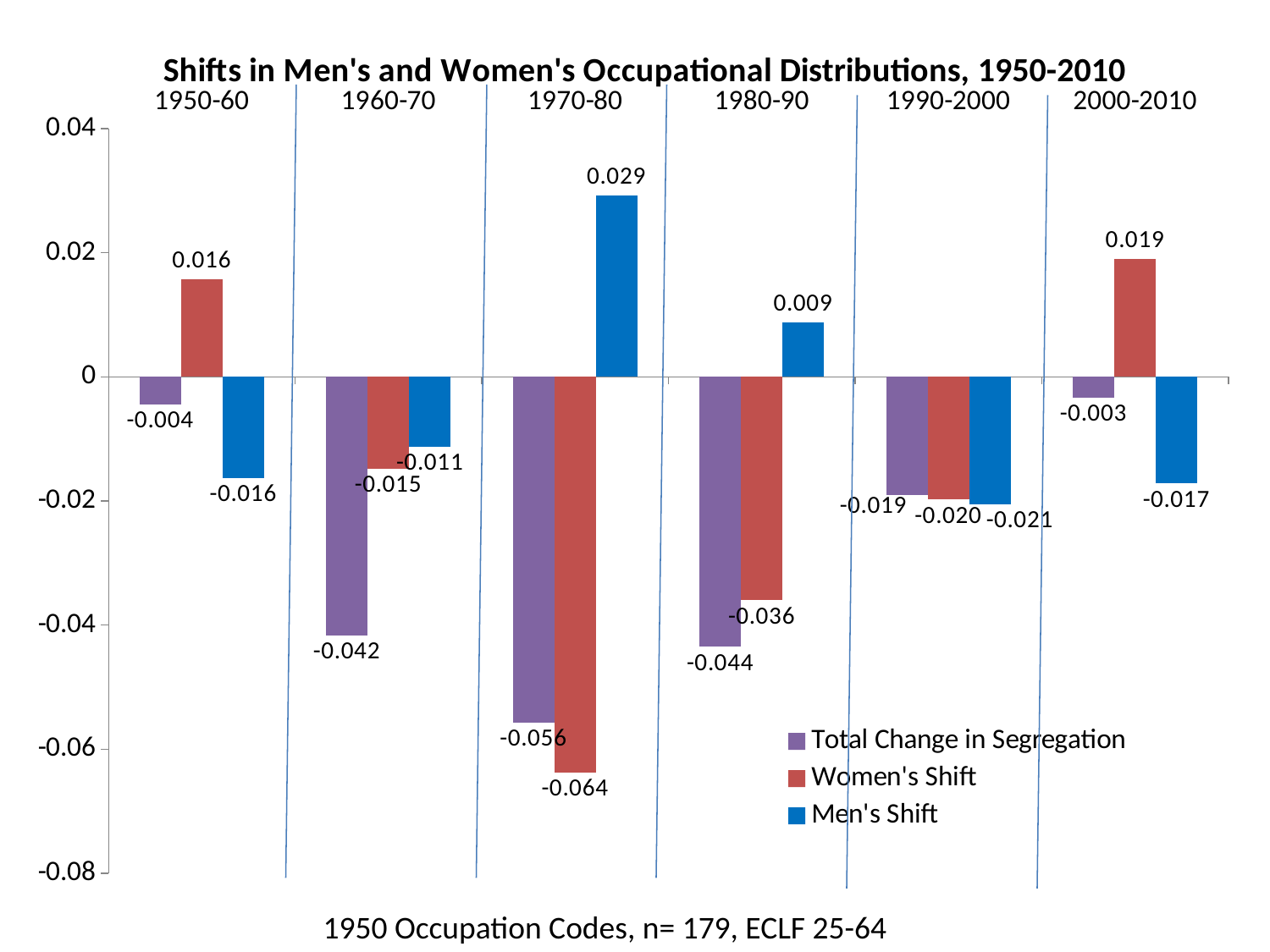
What is the Men's Shift value for 1970-80? 0.029 In which period is the Total Change in Segregation lowest (most negative)? 1970-80 In which period is the Men's Shift highest? 1970-80 What is the Total Change in Segregation for 1960-70? -0.042 What is the Women's Shift value for 2000-2010? 0.019 How many time periods are shown on the x axis? 6 Which series is shown in blue? Men's Shift What is the difference between the Women's Shift and the Men's Shift in 1970-80? 0.093 How many series does the legend list? 3 Which is larger in 1950-60, the Women's Shift or the Men's Shift? Women's Shift What is the Women's Shift value for 1980-90? -0.036 What kind of chart is shown on the slide? Bar chart